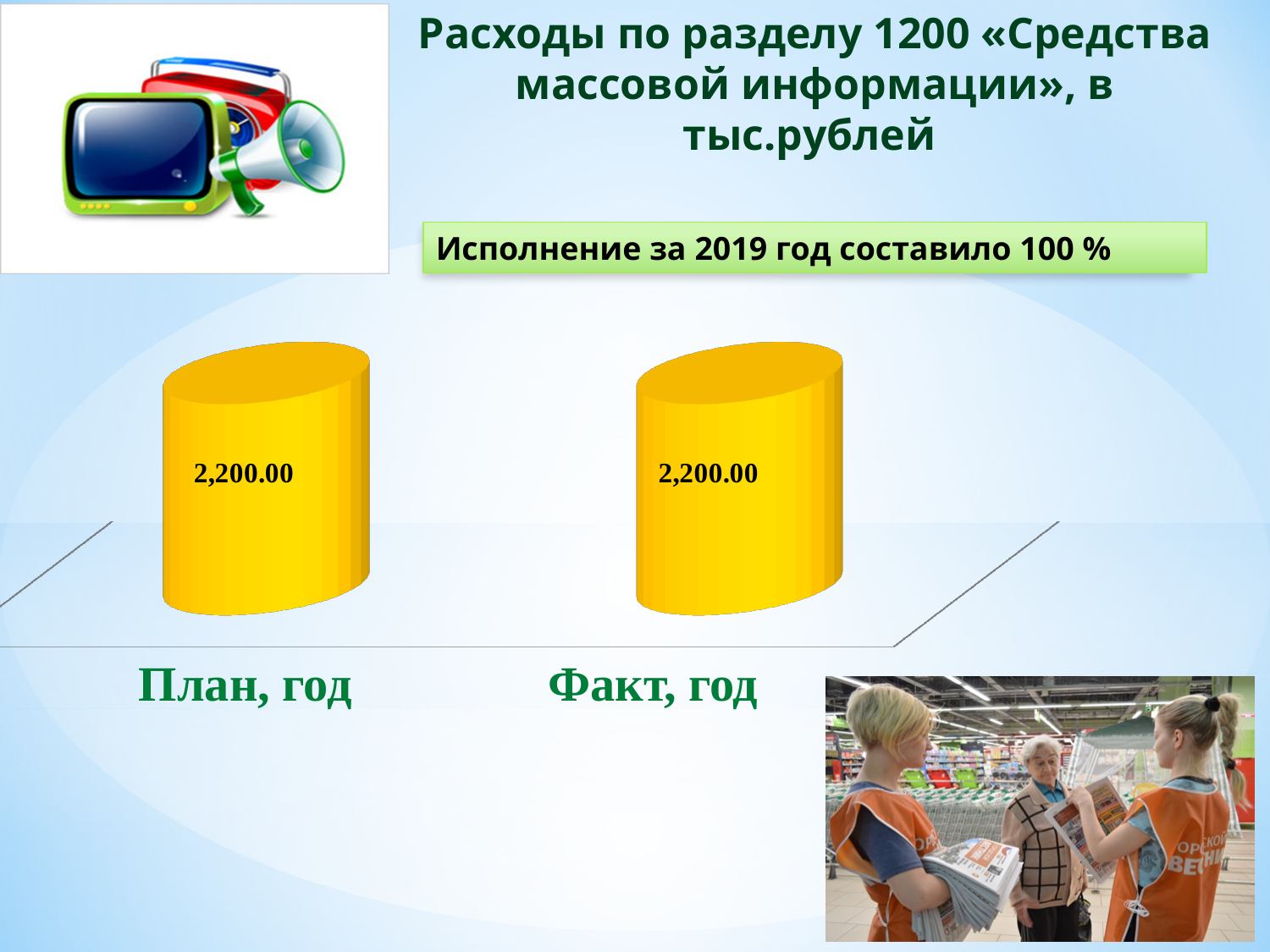
What kind of chart is shown on the slide? Bar chart How many categories are plotted in the chart? 2 What is the title of the chart on the slide? Расходы по разделу 1200 «Средства массовой информации», в тыс.рублей What are the two category labels on the x axis of the chart? План, год and Факт, год What is the value shown for «План, год»? 2,200.00 Is the value for «План, год» larger than, smaller than, or equal to the value for «Факт, год»? Equal What colour are the bars in the chart? Yellow What is the value shown for «Факт, год»? 2,200.00 Is the value for «Факт, год» greater or less than 2,000? greater What is the difference between the values for «План, год» and «Факт, год»? 0.00